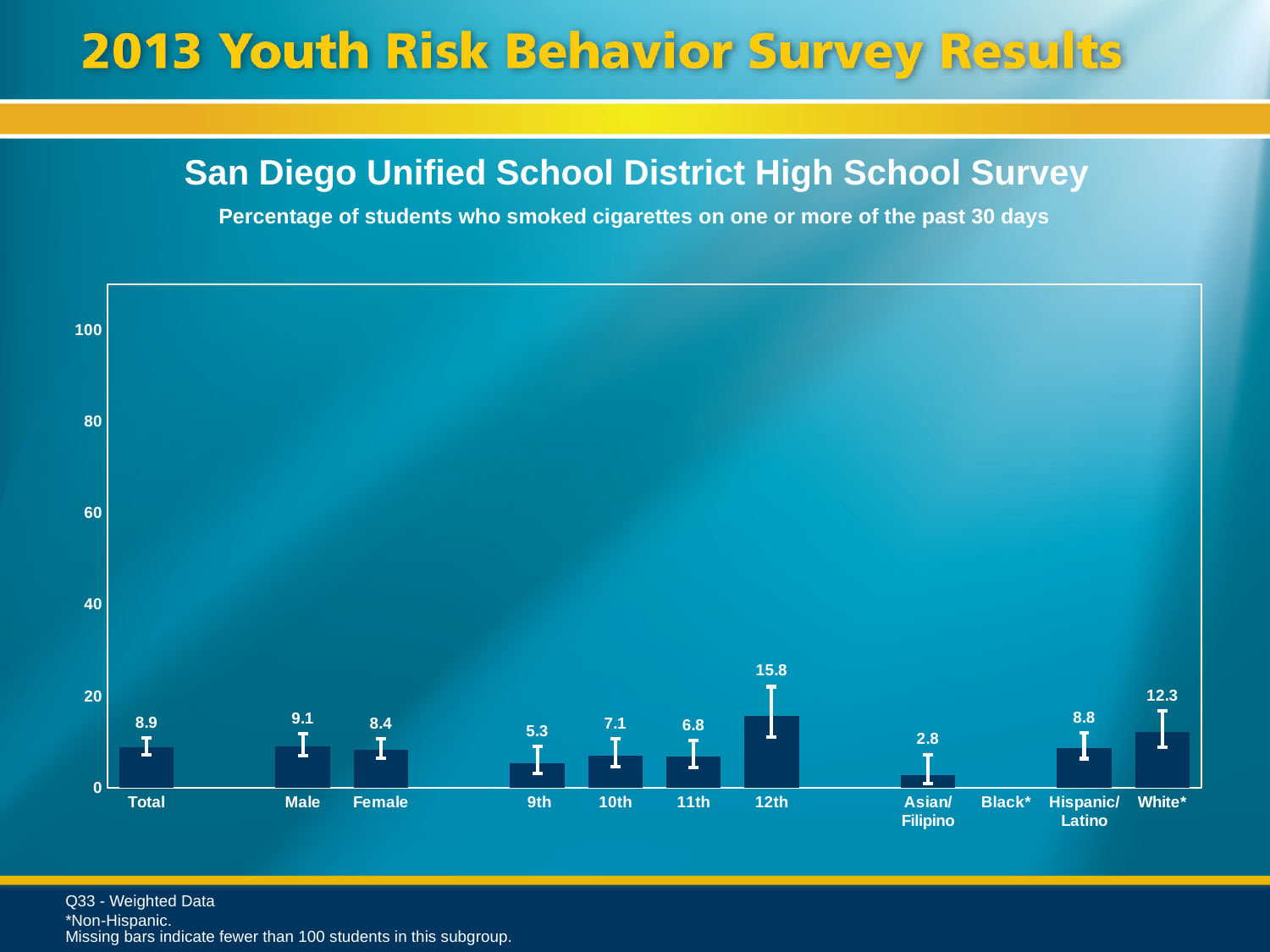
What kind of chart is shown on the slide? bar chart Is the value for 12th graders greater or less than 20? less What is the value shown for Asian/Filipino students? 2.8 Which category with a plotted bar has the lowest value? Asian/Filipino What is the value shown for 12th graders? 15.8 What is the difference between the values for 12th and 9th graders? 10.5 How many bars are plotted on the chart? 10 Which category has the highest value on the chart? 12th What percentage of students in the Total category smoked cigarettes on one or more of the past 30 days? 8.9 What is the difference between the values for Male and Female? 0.7 Which is larger, the value for White* or the value for Hispanic/Latino? White* Which category label on the x axis has no bar plotted? Black*